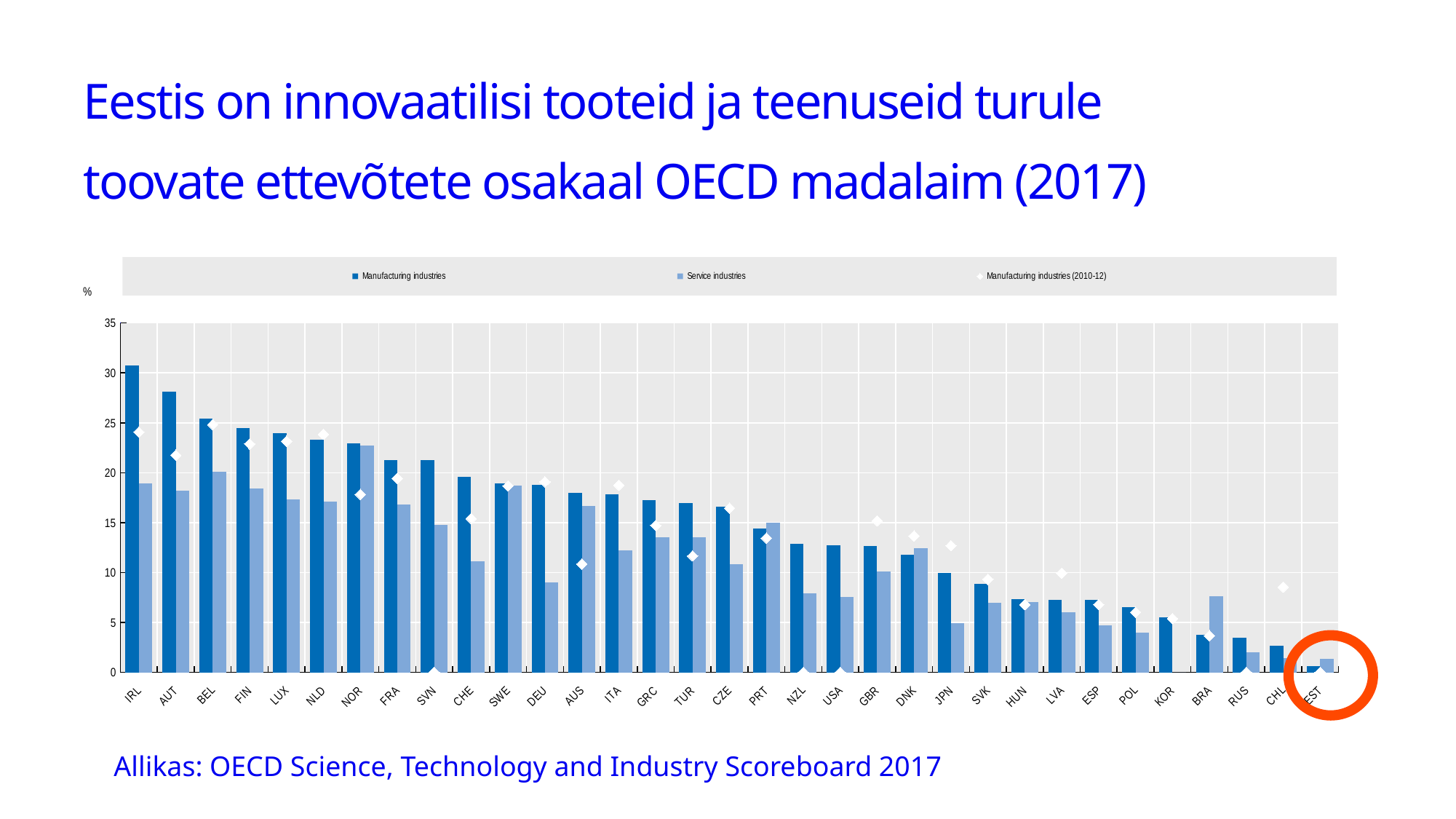
Which country has the highest Manufacturing industries value? IRL Which country has the lowest Manufacturing industries value? EST Is the Manufacturing industries value for EST greater or less than 5? less Is the Manufacturing industries value for IRL greater or less than 30? greater Is the Manufacturing industries value for JPN greater or less than 15? less How many series does the legend list? 3 What kind of chart is shown on the slide? bar chart Which is larger for BRA: the Manufacturing industries bar or the Service industries bar? Service industries Which country is circled in orange on the chart? EST How many countries are shown on the x axis? 33 Do the Manufacturing industries values rise or fall from left to right along the x axis? fall